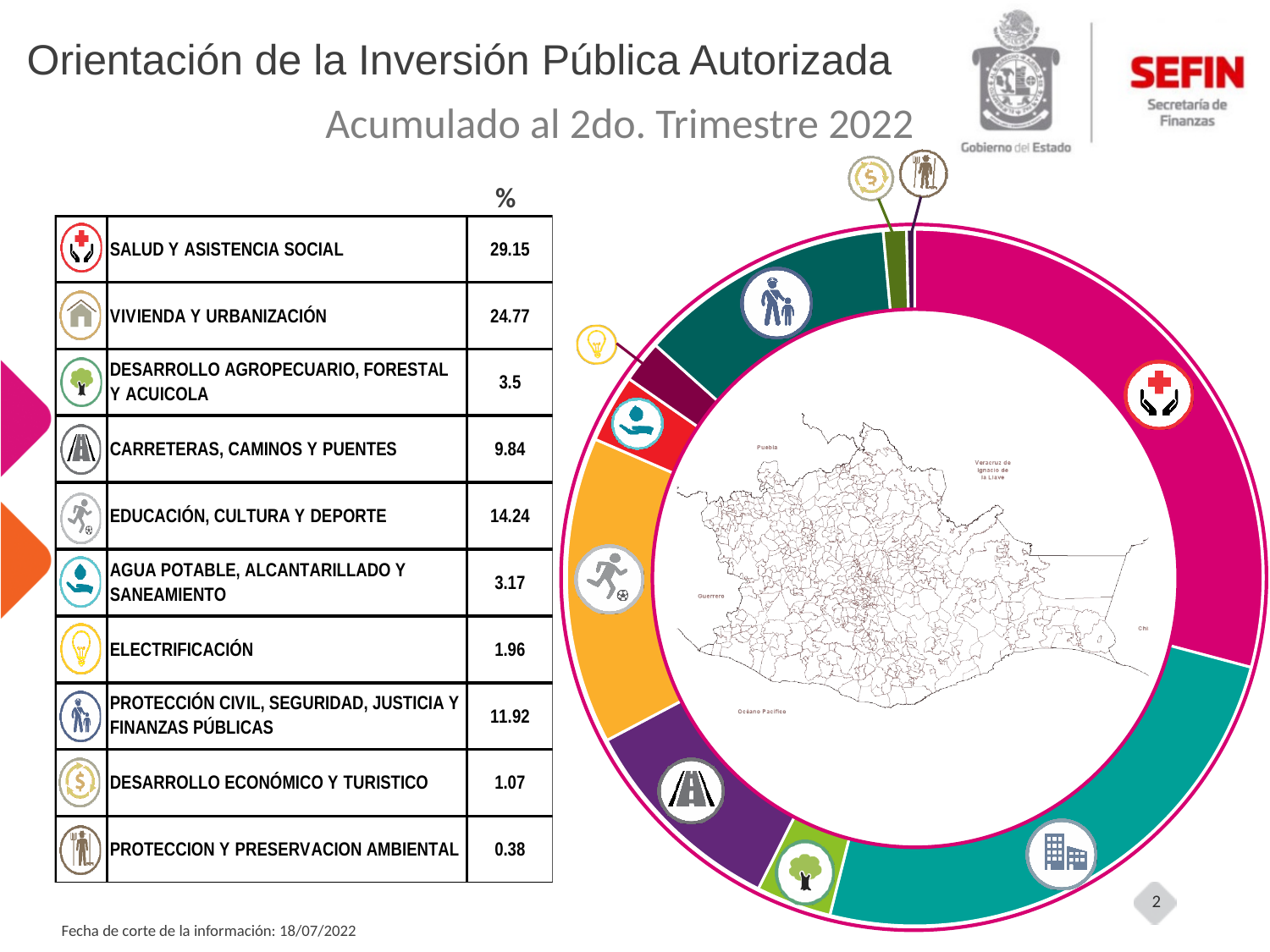
Which category has the lowest percentage? PROTECCION Y PRESERVACION AMBIENTAL What is the difference in percentage between SALUD Y ASISTENCIA SOCIAL and VIVIENDA Y URBANIZACIÓN? 4.38 How many categories are shown in the chart? 10 Which has a larger percentage, CARRETERAS, CAMINOS Y PUENTES or EDUCACIÓN, CULTURA Y DEPORTE? EDUCACIÓN, CULTURA Y DEPORTE What percentage is shown for PROTECCIÓN CIVIL, SEGURIDAD, JUSTICIA Y FINANZAS PÚBLICAS? 11.92 What percentage is shown for SALUD Y ASISTENCIA SOCIAL? 29.15 What is the difference in percentage between EDUCACIÓN, CULTURA Y DEPORTE and PROTECCIÓN CIVIL, SEGURIDAD, JUSTICIA Y FINANZAS PÚBLICAS? 2.32 What percentage is shown for ELECTRIFICACIÓN? 1.96 What percentage is shown for VIVIENDA Y URBANIZACIÓN? 24.77 What is the title of the slide containing the chart? Orientación de la Inversión Pública Autorizada What kind of chart is shown on the slide? Doughnut (pie) chart Which category has the highest percentage? SALUD Y ASISTENCIA SOCIAL